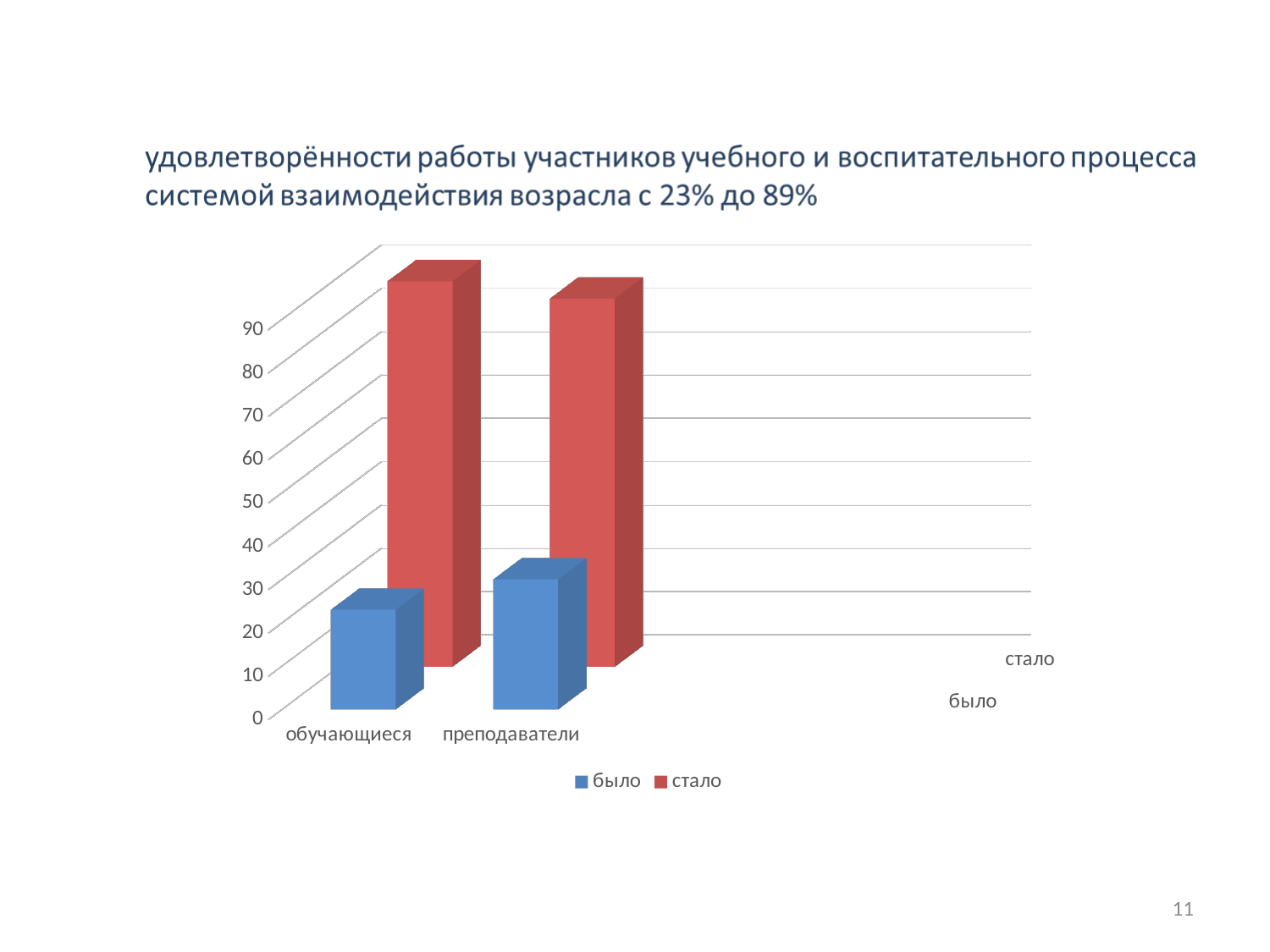
Is the 'стало' value for 'преподаватели' greater or less than 60? greater For the series 'было', which category has the larger value, 'обучающиеся' or 'преподаватели'? преподаватели What kind of chart is shown on the slide? bar chart Is the 'было' value for 'преподаватели' greater or less than 50? less For 'преподаватели', which series has the larger value, 'было' or 'стало'? стало Which colour represents the series 'стало'? red How many series does the chart's legend list? 2 How many categories are shown on the x axis of the chart? 2 What are the two series named in the legend? было, стало For 'обучающиеся', which series has the larger value, 'было' or 'стало'? стало Is the 'стало' value for 'обучающиеся' greater or less than 50? greater